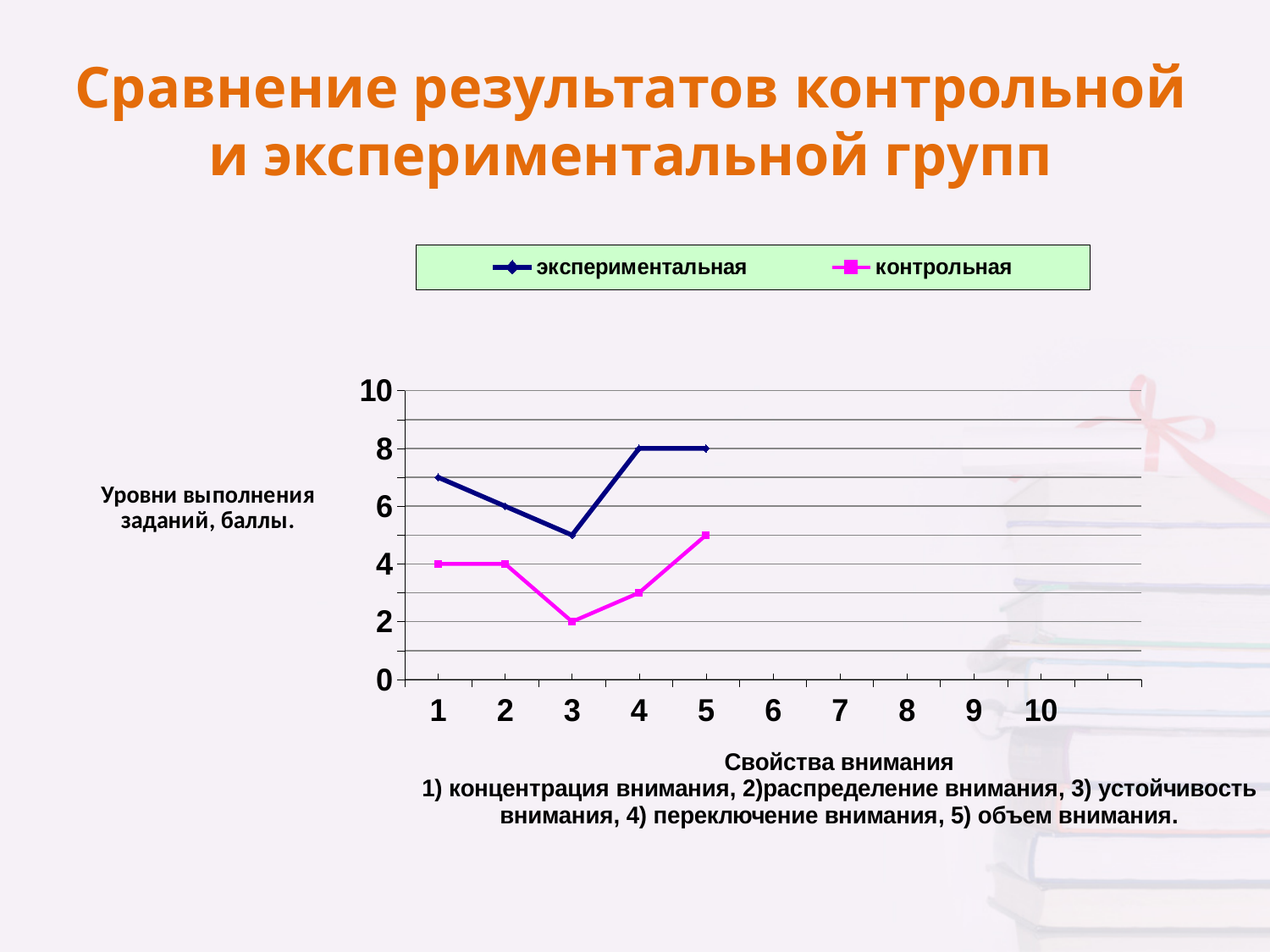
Is the value of the экспериментальная series at category 1 greater or less than 6? greater What is the value of the контрольная series at category 1? 4 What is the value of the контрольная series at category 3? 2 At which category does the контрольная series reach its lowest value? 3 Is the value of the контрольная series at category 5 greater or less than 6? less How many series does the legend list? 2 What type of chart is shown on the slide? line chart What is the difference between the экспериментальная and контрольная values at category 2? 2 At which category does the экспериментальная series reach its lowest value? 3 What is the value of the экспериментальная series at category 2? 6 What is the value of the экспериментальная series at category 4? 8 Which series has the higher value at category 4, экспериментальная or контрольная? экспериментальная